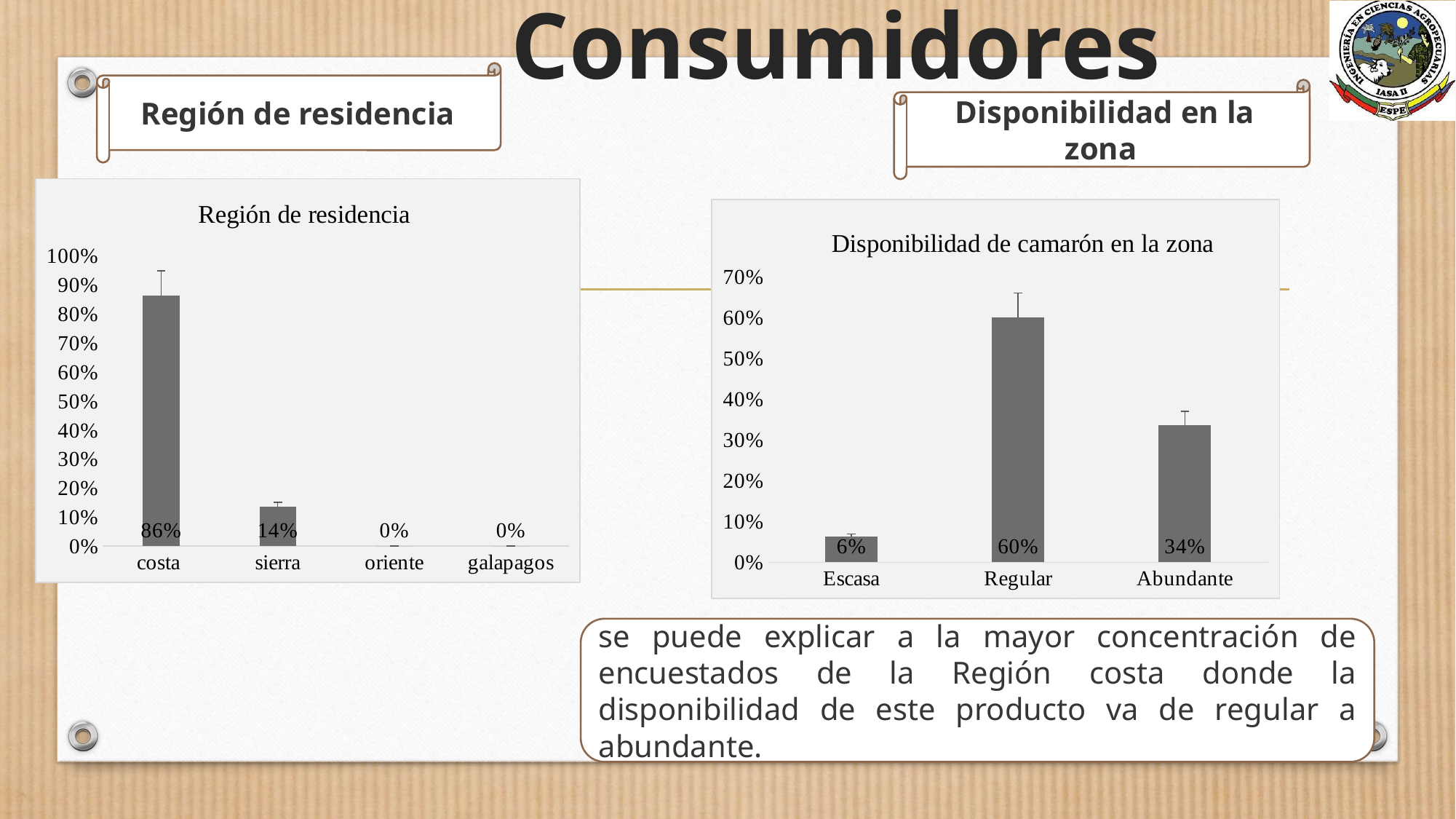
In the 'Disponibilidad de camarón en la zona' chart, which category has the lowest value? Escasa In the 'Región de residencia' chart, how many regions are shown on the x axis? 4 In the 'Disponibilidad de camarón en la zona' chart, what is the difference between Regular and Abundante? 26% In the 'Región de residencia' chart, what is the difference between the values for costa and sierra? 72% In the 'Región de residencia' chart, what kind of chart is shown? bar chart In the 'Región de residencia' chart, which region has the highest value? costa In the 'Disponibilidad de camarón en la zona' chart, what is the value for Escasa? 6% In the 'Región de residencia' chart, what is the value for costa? 86% In the 'Disponibilidad de camarón en la zona' chart, what is the value for Regular? 60% In the 'Disponibilidad de camarón en la zona' chart, which is larger, Regular or Abundante? Regular In the 'Disponibilidad de camarón en la zona' chart, how many categories are shown on the x axis? 3 In the 'Región de residencia' chart, what is the value for sierra? 14%